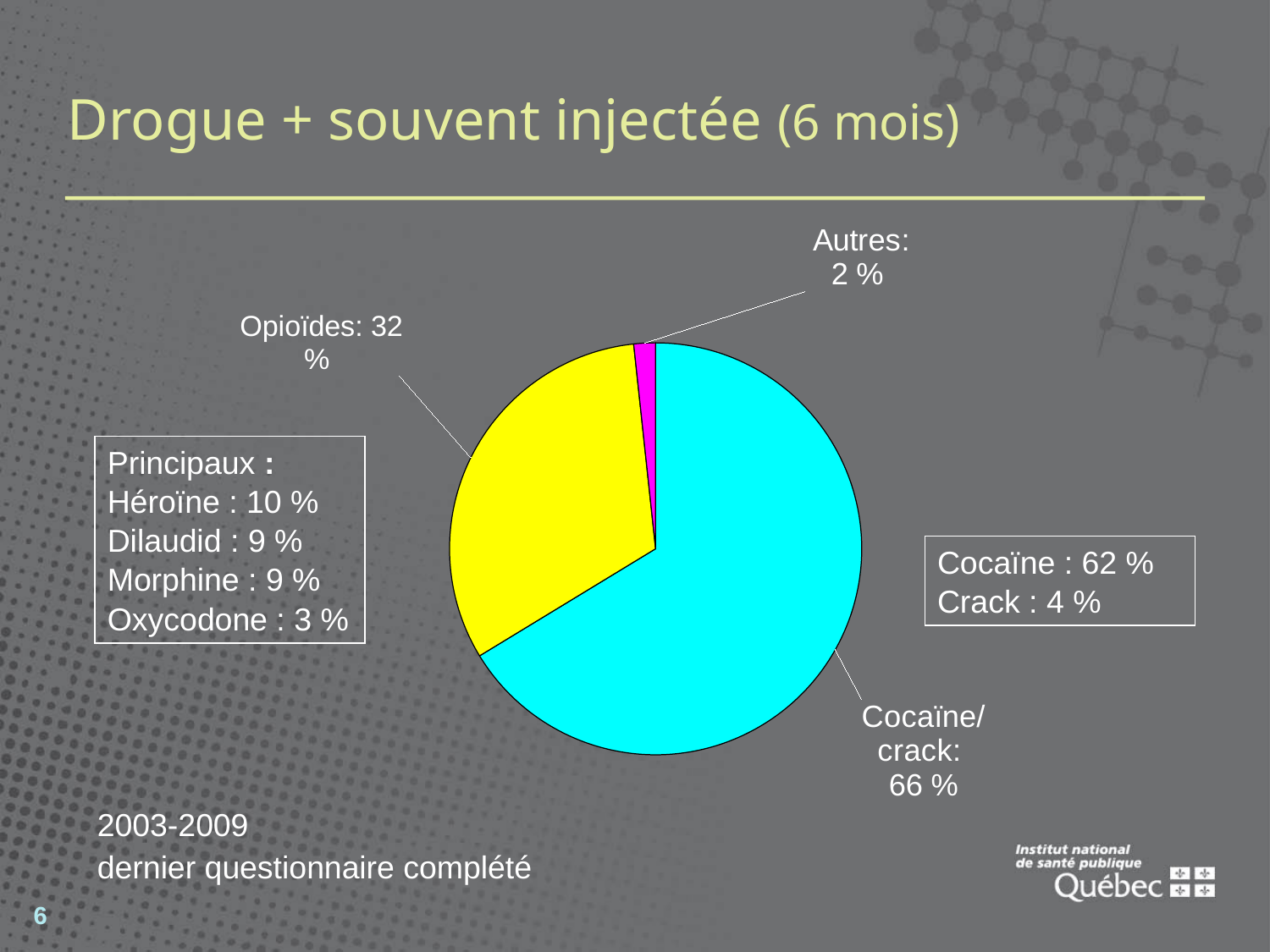
What share of the pie does Opioïdes represent? 32 % What share of the pie does Cocaïne/crack represent? 66 % What colour is the Cocaïne/crack slice? cyan What share of the pie does Autres represent? 2 % Which slice of the pie is the smallest? Autres What is the combined share of Opioïdes and Autres? 34 % How many slices does the pie chart have? 3 Which slice of the pie is the largest? Cocaïne/crack Which is larger, the Opioïdes slice or the Autres slice? Opioïdes What is the difference in percentage points between Cocaïne/crack and Opioïdes? 34 What is the title of the slide containing the pie chart? Drogue + souvent injectée (6 mois) What type of chart is shown on the slide? pie chart